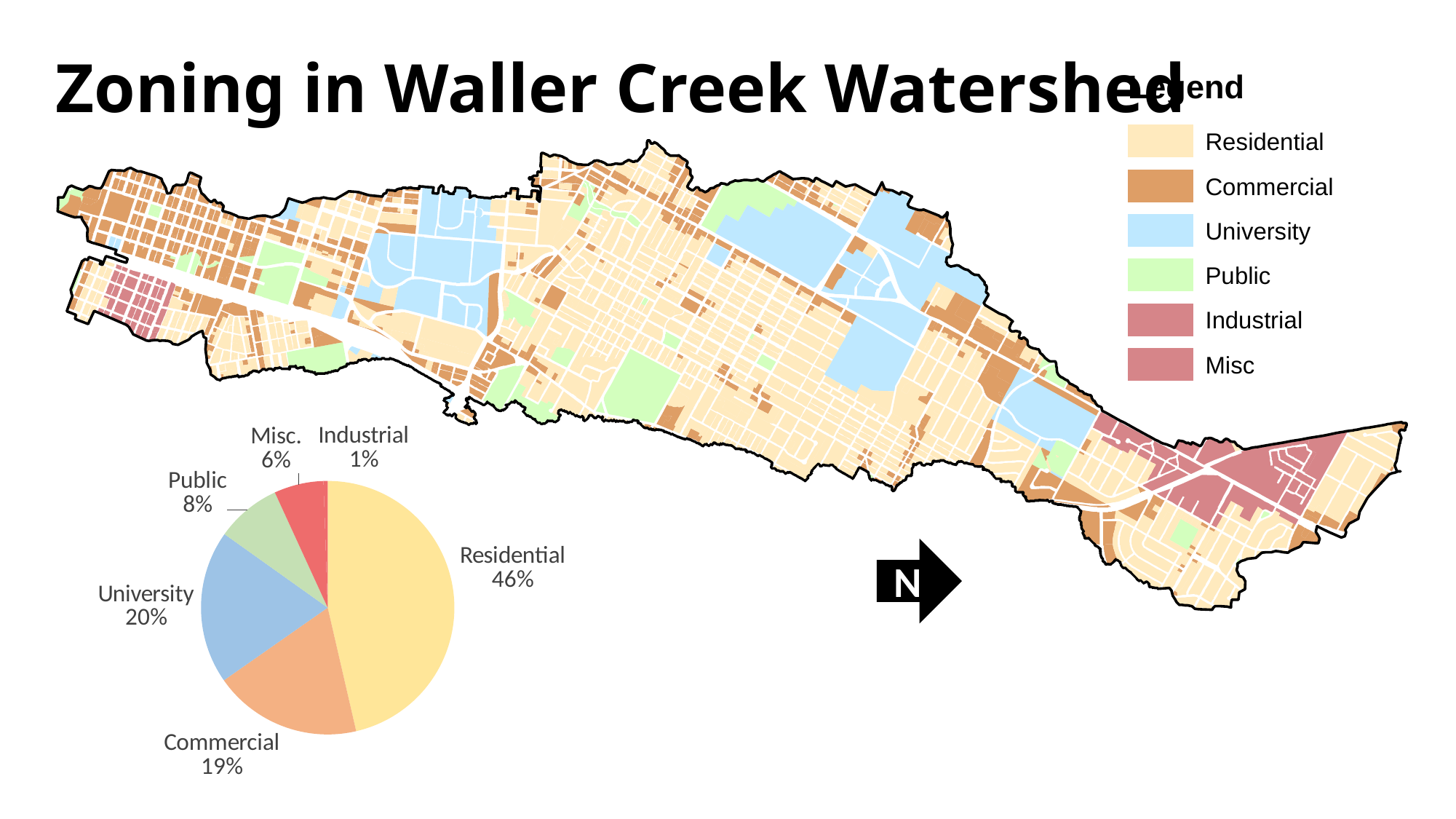
In the pie chart, what share is University? 20% In the pie chart, what share is Public? 8% In the pie chart, which category has the largest share? Residential In the pie chart, how many percentage points larger is Residential than Commercial? 27 In the pie chart, what share is Industrial? 1% In the pie chart, which is larger, University or Commercial? University In the pie chart, what share is Residential? 46% What kind of chart is shown at the bottom left of the slide? pie chart How many slices does the pie chart have? 6 In the pie chart, what share is Commercial? 19% What is the title of the slide? Zoning in Waller Creek Watershed In the pie chart, which category has the smallest share? Industrial